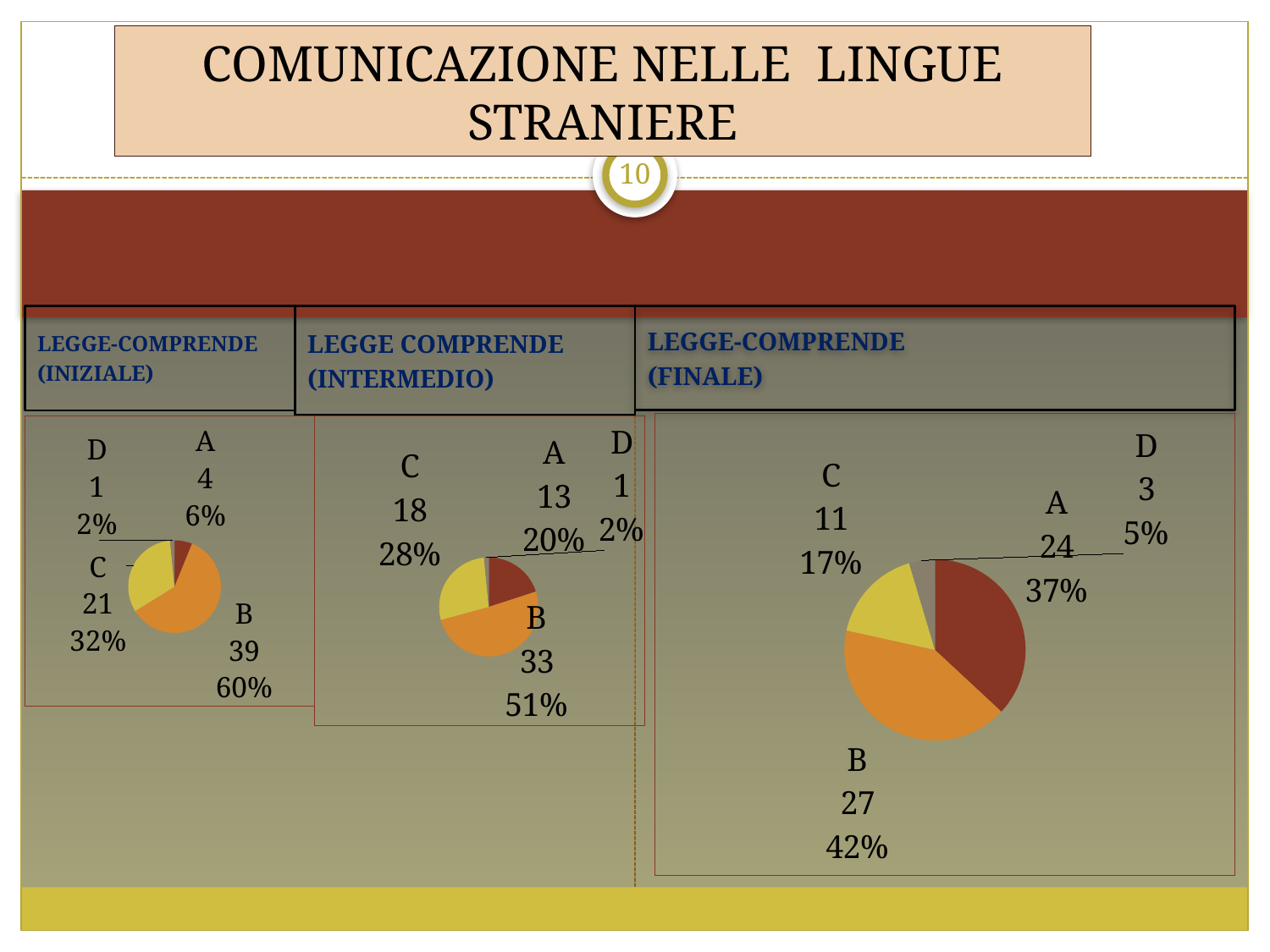
In the LEGGE-COMPRENDE (FINALE) chart, what is the count for category C? 11 In the LEGGE COMPRENDE (INTERMEDIO) chart, what is the count for category A? 13 In the LEGGE-COMPRENDE (INIZIALE) chart, what share of the pie does category C have? 32% In the LEGGE-COMPRENDE (INIZIALE) chart, which category has the smallest slice? D In the LEGGE-COMPRENDE (FINALE) chart, what is the difference between the counts for B and A? 3 In the LEGGE COMPRENDE (INTERMEDIO) chart, which category has the largest slice? B How many categories does the LEGGE-COMPRENDE (FINALE) chart show? 4 In the LEGGE-COMPRENDE (FINALE) chart, what share of the pie does category A have? 37% What kind of chart is used for LEGGE-COMPRENDE (INIZIALE)? Pie chart In the LEGGE-COMPRENDE (FINALE) chart, which is larger, the count for C or the count for D? C In the LEGGE-COMPRENDE (INIZIALE) chart, what is the count for category B? 39 In the LEGGE COMPRENDE (INTERMEDIO) chart, what share of the pie does category B have? 51%